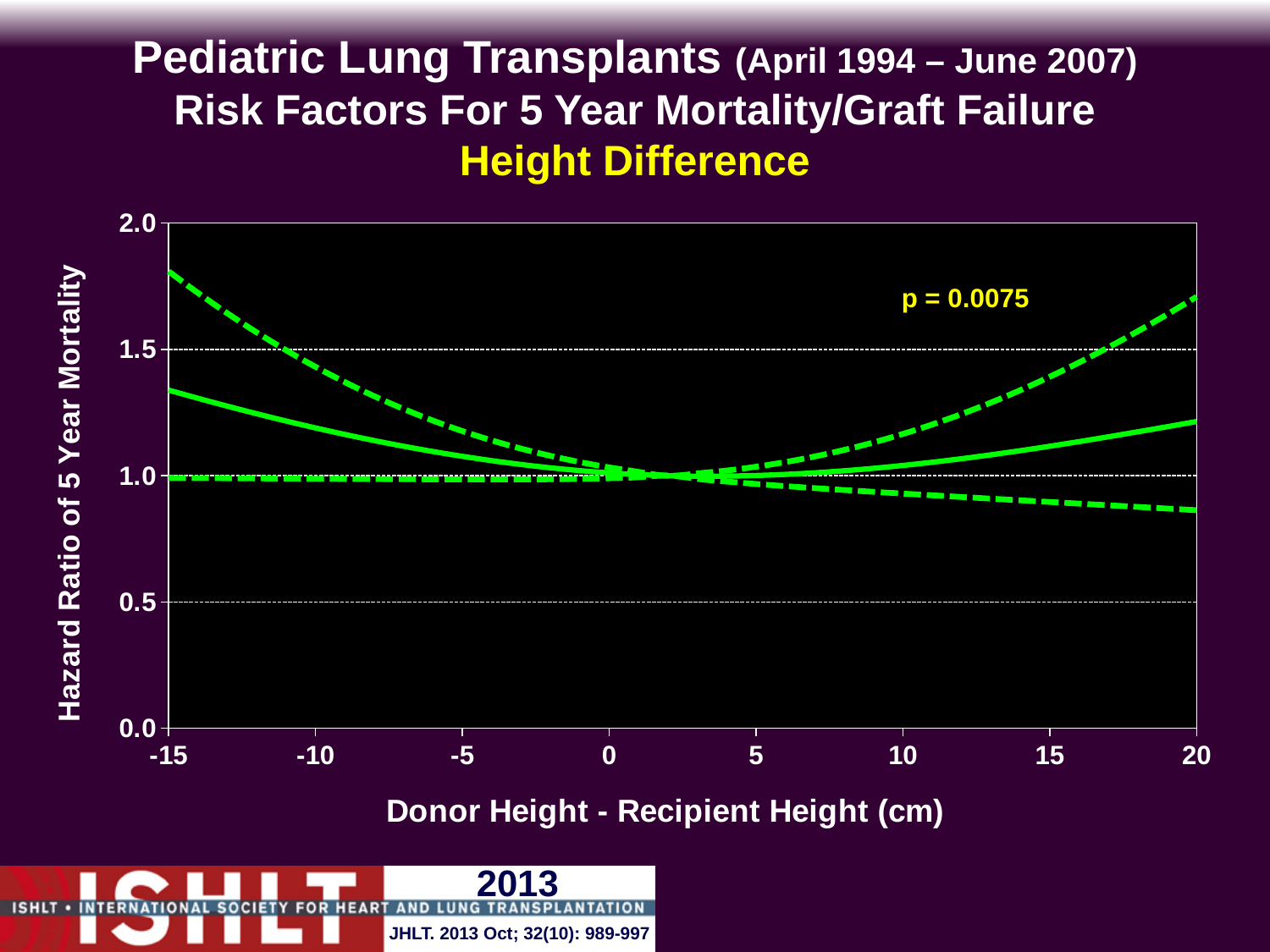
Is the value of the upper dashed line at a height difference of -15 cm greater or less than 1.5? greater How many lines are plotted on the chart? 3 What is the label of the x axis? Donor Height - Recipient Height (cm) Does the solid line rise or fall as the height difference goes from 5 cm to 20 cm? rise Does the solid line rise or fall as the height difference goes from -15 cm to 0 cm? fall Is the value of the solid line at a height difference of 20 cm greater or less than 1.5? less Is the value of the solid line at a height difference of -15 cm greater or less than 1.0? greater How many tick labels are shown on the x axis? 8 What kind of chart is shown on the slide? line chart Which is larger for the solid line: the value at -15 cm or the value at 20 cm? the value at -15 cm What p-value is printed on the chart? p = 0.0075